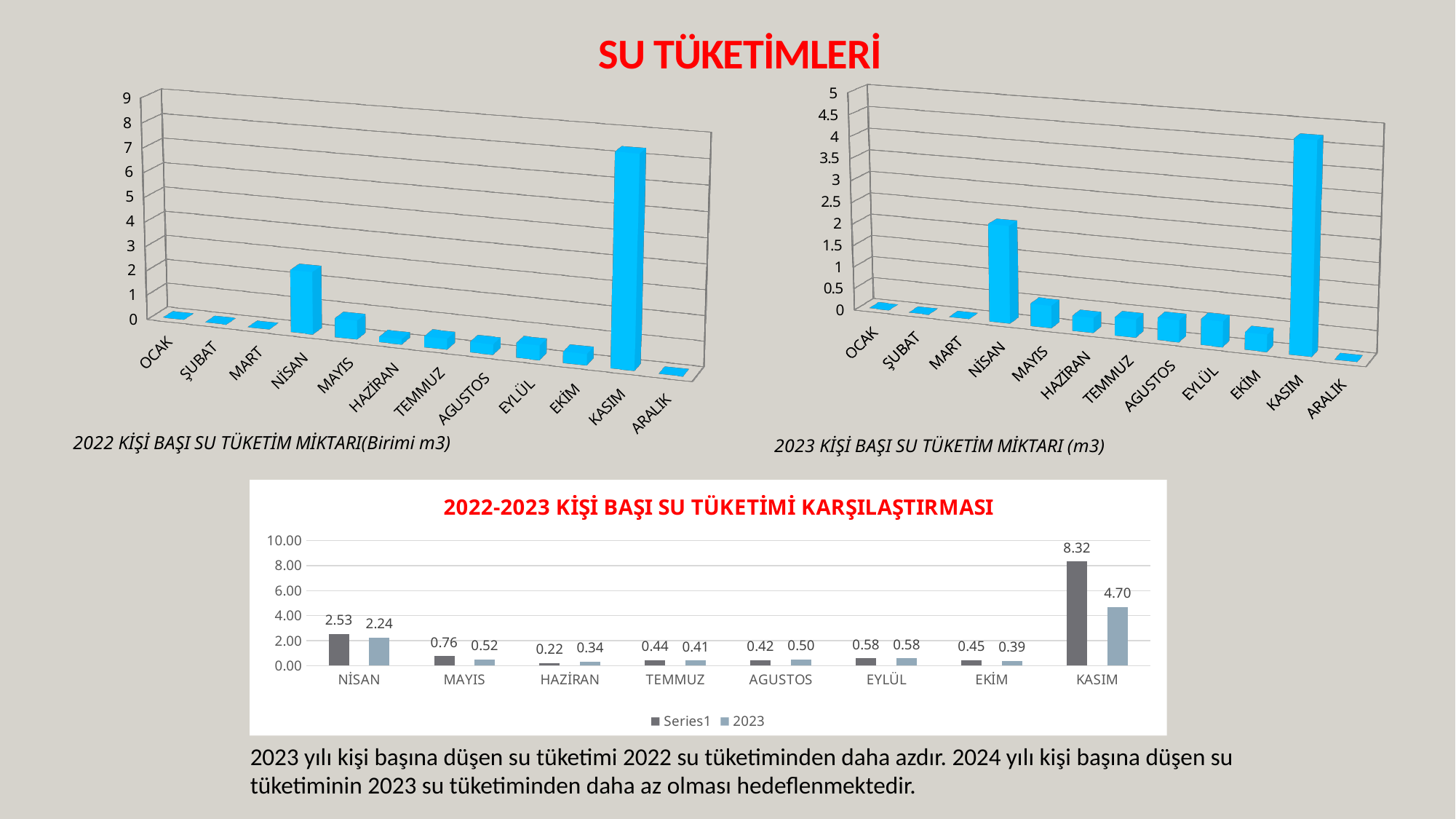
In the bottom chart titled '2022-2023 KİŞİ BAŞI SU TÜKETİMİ KARŞILAŞTIRMASI', what is the Series1 value for KASIM? 8.32 In the top-left chart '2022 KİŞİ BAŞI SU TÜKETİM MİKTARI(Birimi m3)', is the value for KASIM greater or less than 5? greater In the bottom comparison chart, what is the difference between the Series1 and 2023 values for KASIM? 3.62 In the bottom comparison chart, what is the 2023 value for NİSAN? 2.24 In the bottom comparison chart, what is the 2023 value for HAZİRAN? 0.34 In the bottom comparison chart, which is larger for MAYIS: the Series1 value or the 2023 value? Series1 In the bottom comparison chart, which month has the highest 2023 value? KASIM How many series does the legend of the bottom comparison chart list? 2 How many months are shown on the x axis of the bottom comparison chart? 8 In the bottom comparison chart, which month has the lowest Series1 value? HAZİRAN In the top-right chart '2023 KİŞİ BAŞI SU TÜKETİM MİKTARI (m3)', is the value for KASIM greater or less than 3? greater How many months are shown on the x axis of the top-left 2022 chart? 12